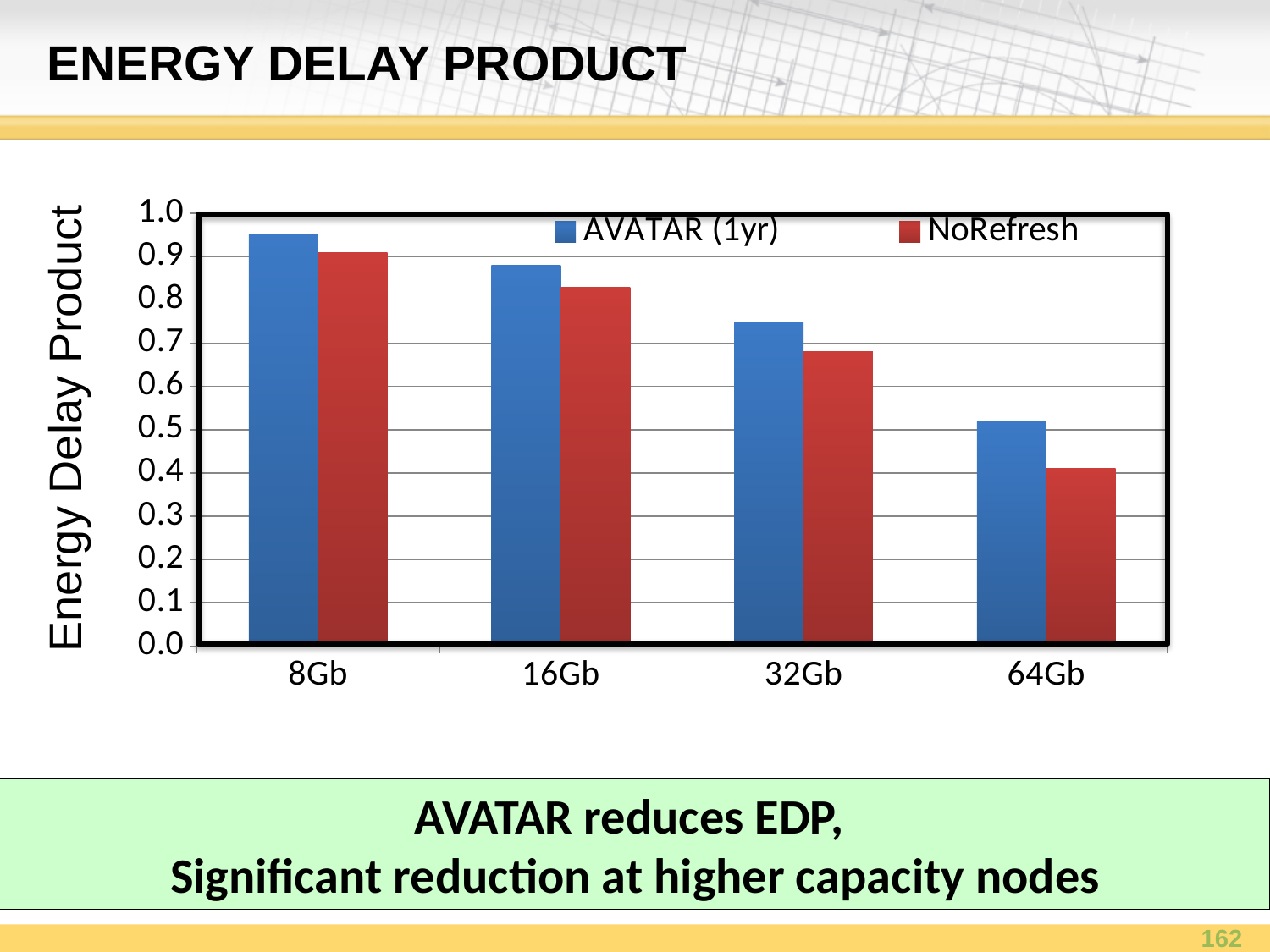
Do the AVATAR (1yr) values rise or fall as capacity increases from 8Gb to 64Gb? fall At 64Gb, which series has the larger value, AVATAR (1yr) or NoRefresh? AVATAR (1yr) Is the AVATAR (1yr) value for 8Gb greater or less than 0.9? greater Which category has the highest AVATAR (1yr) value? 8Gb Is the AVATAR (1yr) value for 64Gb greater or less than 0.6? less Is the NoRefresh value for 32Gb greater or less than 0.6? greater What is the label on the y axis? Energy Delay Product How many series does the legend list? 2 Which category has the lowest NoRefresh value? 64Gb How many capacity categories are shown on the x axis? 4 What kind of chart is shown on the slide? bar chart